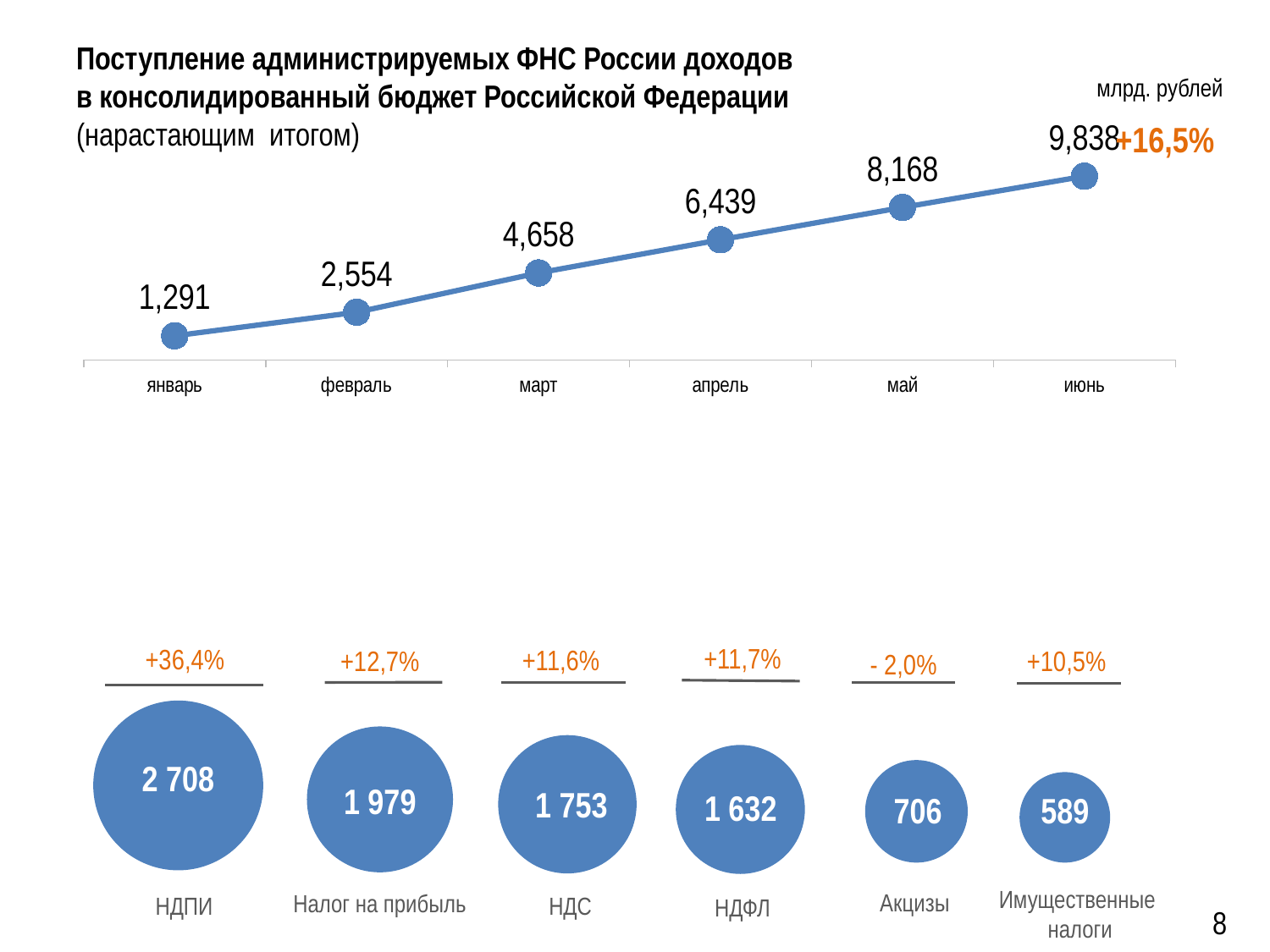
In the top line chart, what is the value for июнь? 9,838 In the bottom bubble chart, what percentage change is shown above Акцизы? - 2,0% In the top line chart, what is the difference between the values for июнь and май? 1,670 In the bottom bubble chart, which category has the highest value? НДПИ In the bottom bubble chart, which category has the lowest value? Имущественные налоги In the bottom bubble chart, what is the value for НДС? 1 753 In the top line chart, what percentage change is shown next to the июнь value? +16,5% In the top line chart, how many months are plotted on the x axis? 6 In the top line chart, do the values rise or fall from январь to июнь? rise In the top line chart, what is the value for март? 4,658 In the bottom bubble chart, what is the difference between the values for НДПИ and Налог на прибыль? 729 What kind of chart is the top chart on the slide? line chart